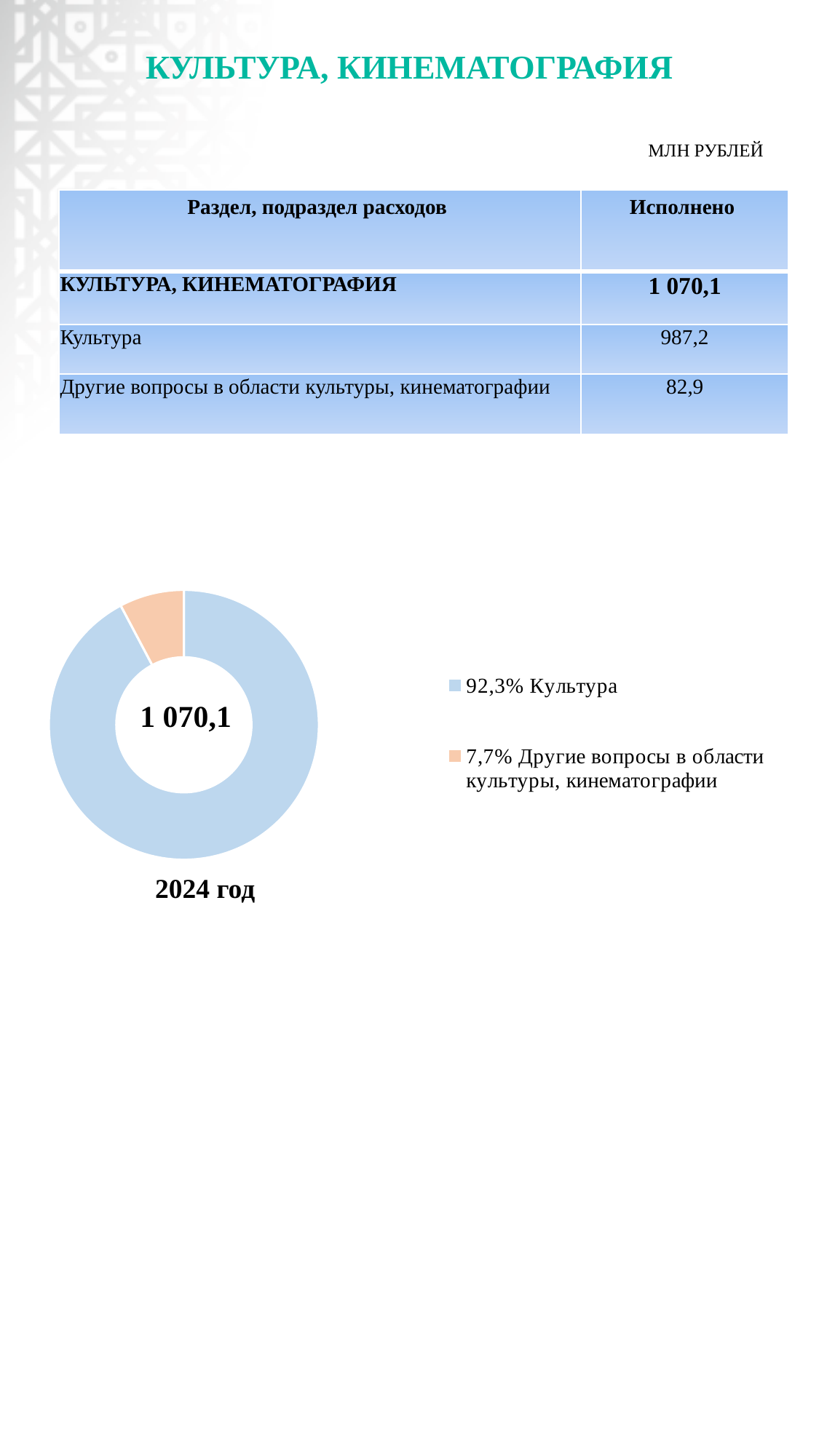
What colour is the Культура slice in the doughnut chart? Light blue What total value is printed in the centre of the doughnut chart? 1 070,1 Which slice is larger: Культура or Другие вопросы в области культуры, кинематографии? Культура What is the difference in percentage points between the Культура share and the Другие вопросы в области культуры, кинематографии share? 84,6 Which category has the smallest slice in the doughnut chart? Другие вопросы в области культуры, кинематографии How many slices does the doughnut chart have? 2 Which category has the largest slice in the doughnut chart? Культура What share of the doughnut chart does Другие вопросы в области культуры, кинематографии account for? 7,7% What year label is shown under the doughnut chart? 2024 год What kind of chart is shown on the slide? Doughnut (pie) chart What share of the doughnut chart does Культура account for? 92,3%